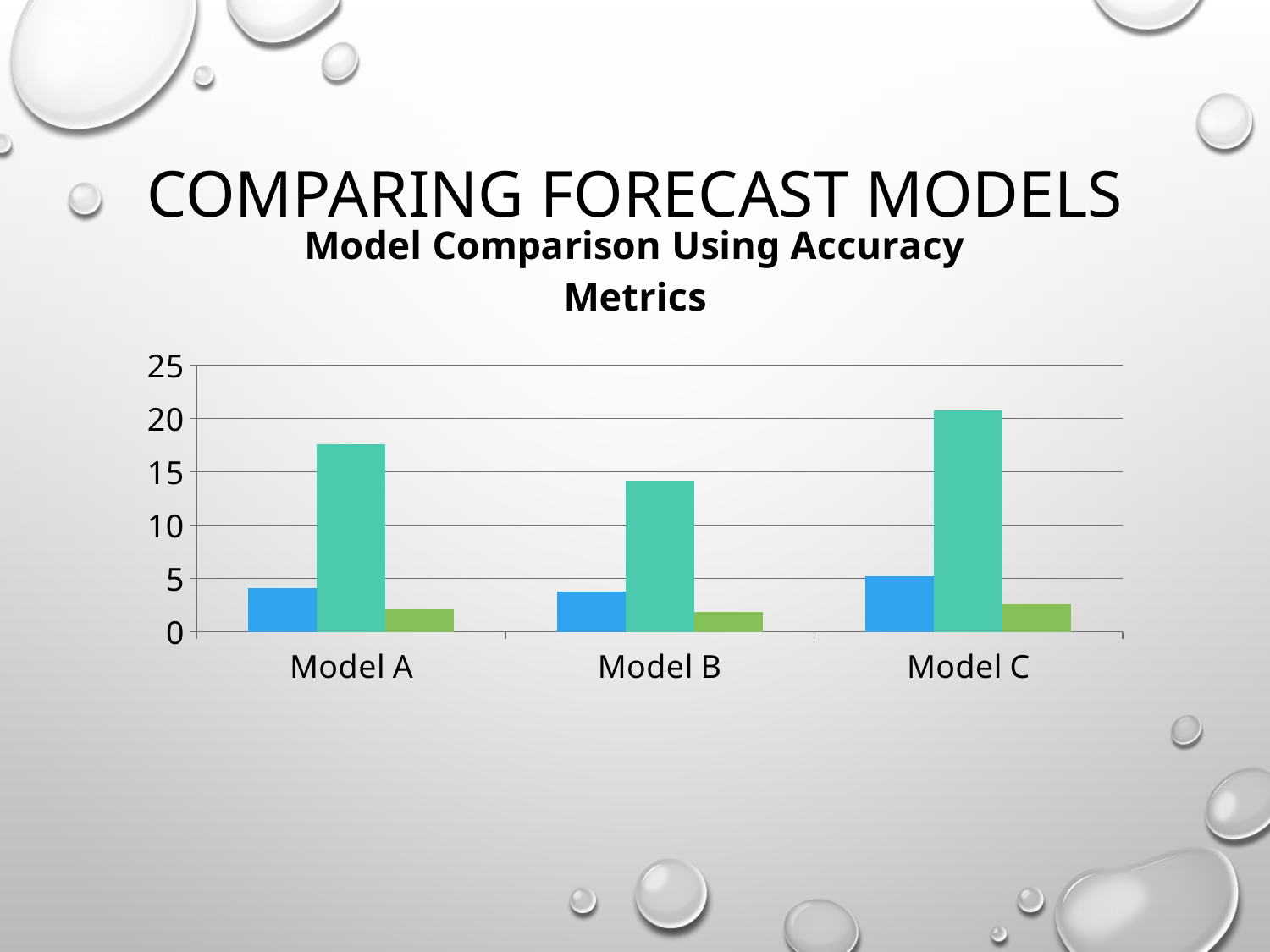
Is the teal bar for Model C greater or less than 15? greater Is the teal bar taller for Model A or for Model B? Model A What is the title of the chart? Model Comparison Using Accuracy Metrics How many bars are plotted for each model in the chart? 3 Which model has the tallest teal bar? Model C Is the blue bar for Model C greater or less than 10? less Is the blue bar taller for Model C or for Model B? Model C Is the teal bar for Model A greater or less than 15? greater What kind of chart is shown on the slide? bar chart How many models (categories) are shown on the x axis of the chart? 3 Which model has the shortest teal bar? Model B